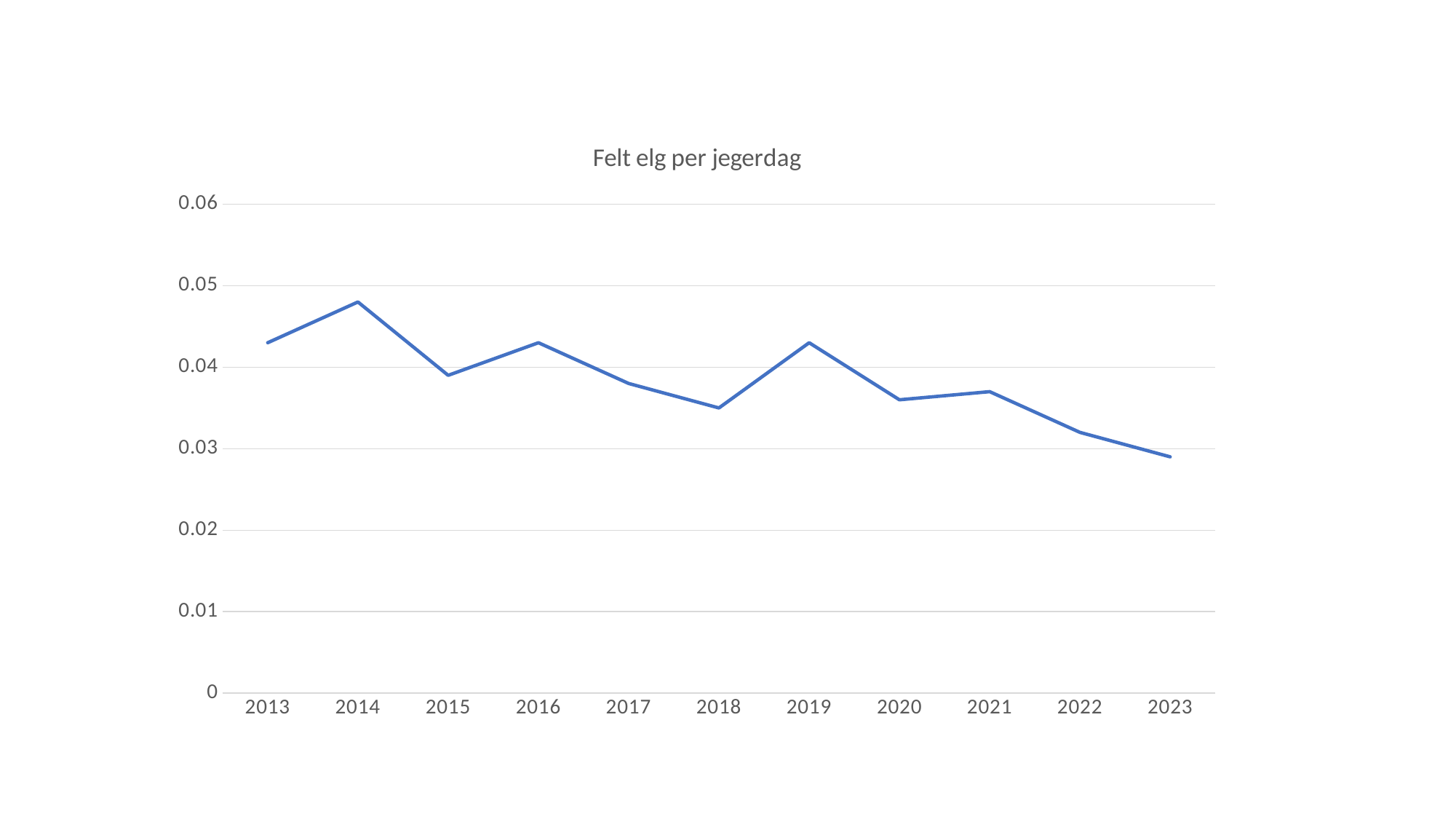
What is the title of the chart? Felt elg per jegerdag Is the value for 2018 greater or less than 0.04? less Overall, do the values rise or fall from 2013 to 2023? fall Which year has the lowest value? 2023 How many years are plotted on the x axis? 11 Which is larger, the value for 2019 or the value for 2023? 2019 What kind of chart is shown on the slide? line chart Is the value for 2013 greater or less than 0.04? greater Is the value for 2020 greater or less than 0.04? less Which is larger, the value for 2014 or the value for 2018? 2014 Which year has the highest value? 2014